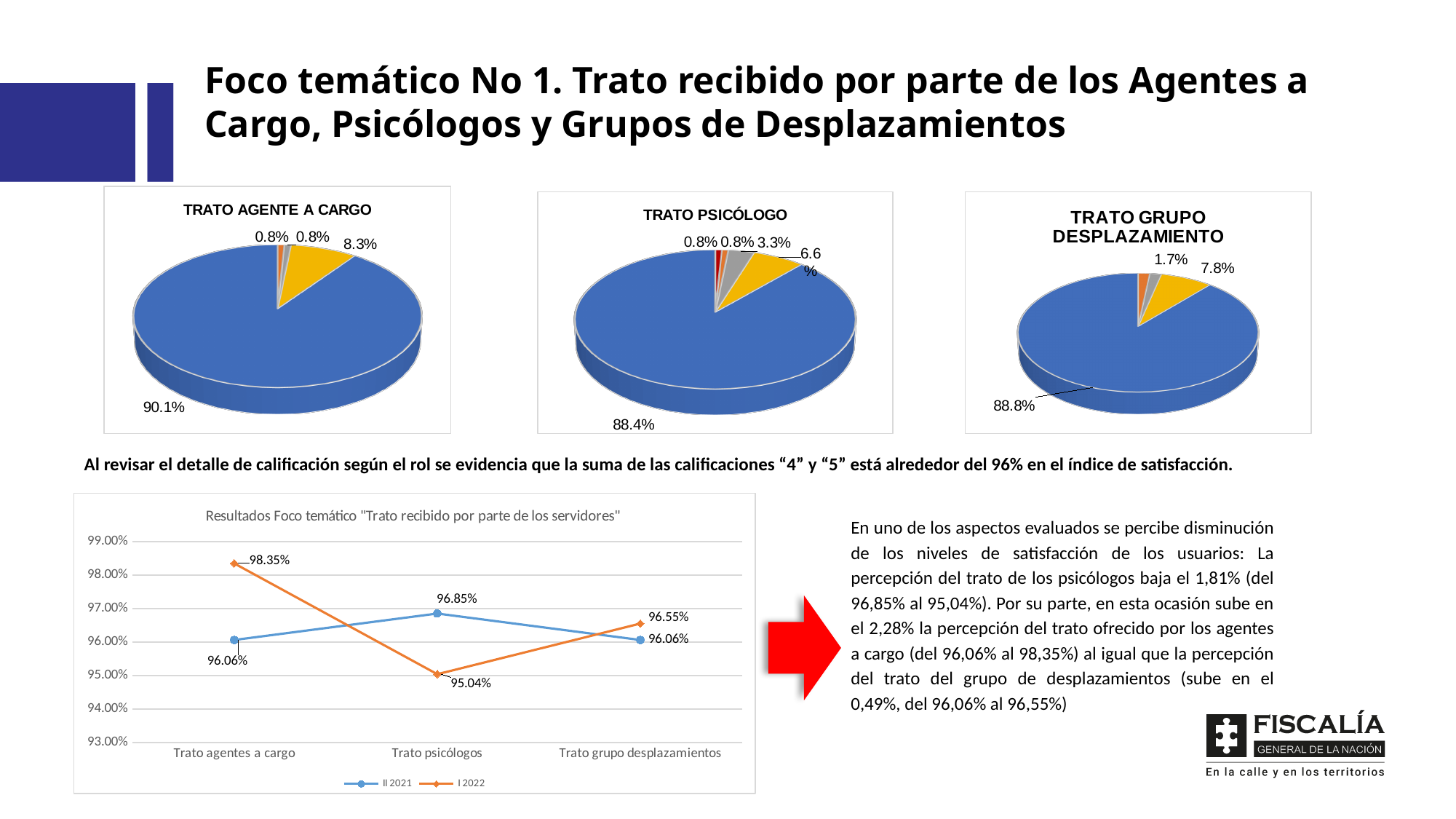
In the line chart 'Resultados Foco temático', which category has the lowest I 2022 value? Trato psicólogos In the line chart 'Resultados Foco temático', what is the I 2022 value for Trato agentes a cargo? 98.35% What is the value of the largest slice in the pie chart 'TRATO AGENTE A CARGO'? 90.1% In the line chart 'Resultados Foco temático', which series has the larger value for Trato grupo desplazamientos, II 2021 or I 2022? I 2022 In the line chart 'Resultados Foco temático', what is the I 2022 value for Trato grupo desplazamientos? 96.55% What is the value of the largest slice in the pie chart 'TRATO PSICÓLOGO'? 88.4% In the line chart 'Resultados Foco temático', what is the II 2021 value for Trato psicólogos? 96.85% How many categories are shown on the x axis of the line chart 'Resultados Foco temático'? 3 In the line chart 'Resultados Foco temático', what is the difference between the II 2021 and I 2022 values for Trato psicólogos? 1.81% In the line chart 'Resultados Foco temático', which category has the highest I 2022 value? Trato agentes a cargo How many series does the legend of the line chart 'Resultados Foco temático' list? 2 What kind of chart is 'TRATO GRUPO DESPLAZAMIENTO'? Pie chart